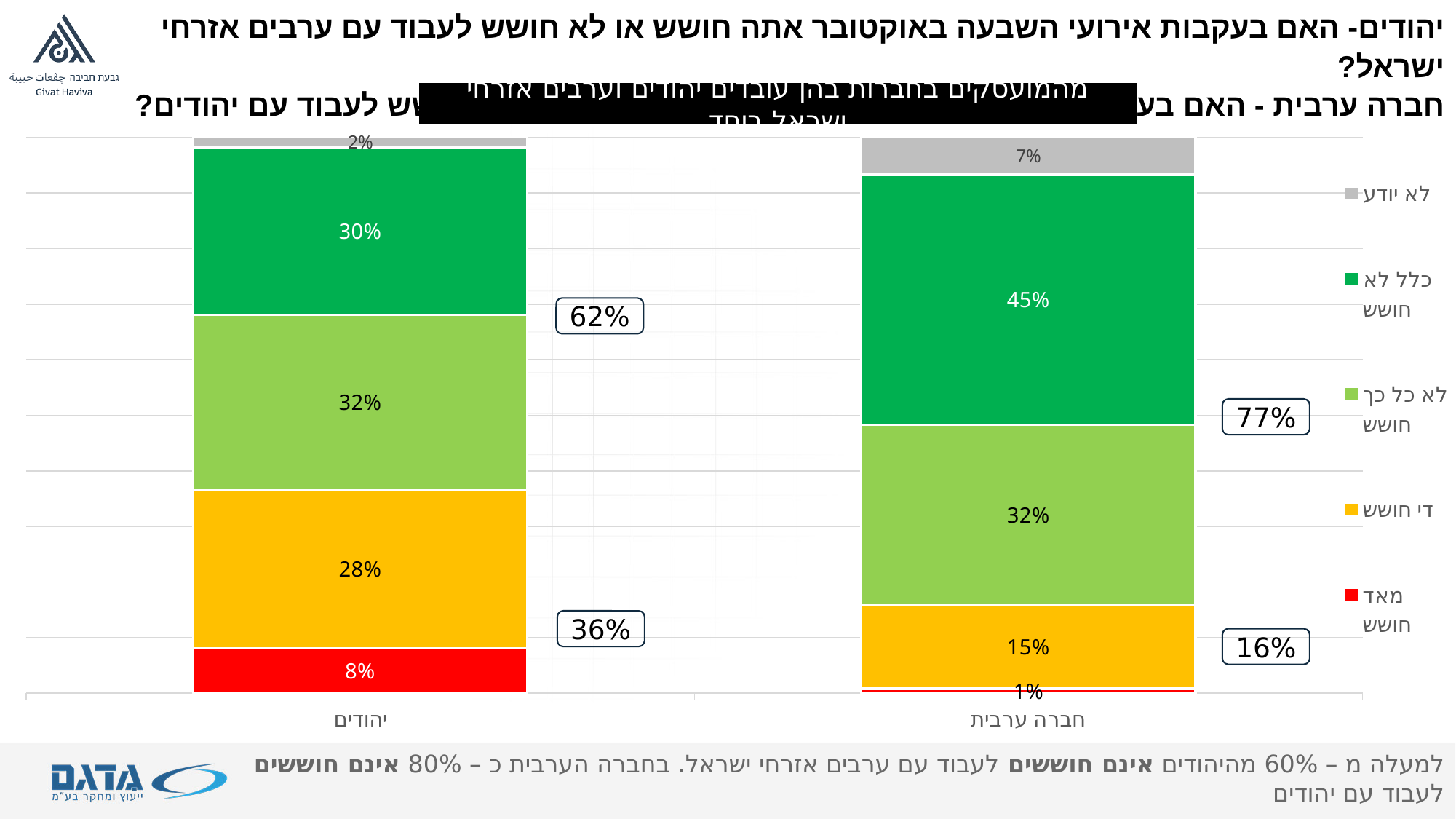
What is the difference between the 'כלל לא חושש' values for 'חברה ערבית' and 'יהודים'? 15% Which segment is the largest in the 'חברה ערבית' bar? כלל לא חושש How many categories (bars) are shown on the x axis? 2 What is the value of the 'מאד חושש' segment for the 'חברה ערבית' bar? 1% What is the value of the 'לא יודע' segment for the 'חברה ערבית' bar? 7% Which segment is the smallest in the 'יהודים' bar? לא יודע Which bar has the larger 'די חושש' segment, 'יהודים' or 'חברה ערבית'? יהודים What is the value of the 'כלל לא חושש' segment for the 'יהודים' bar? 30% What is the value of the 'די חושש' segment for the 'יהודים' bar? 28% What kind of chart is shown on the slide? Stacked bar chart How many series does the legend list? 5 What colour represents the 'מאד חושש' series in the legend? Red